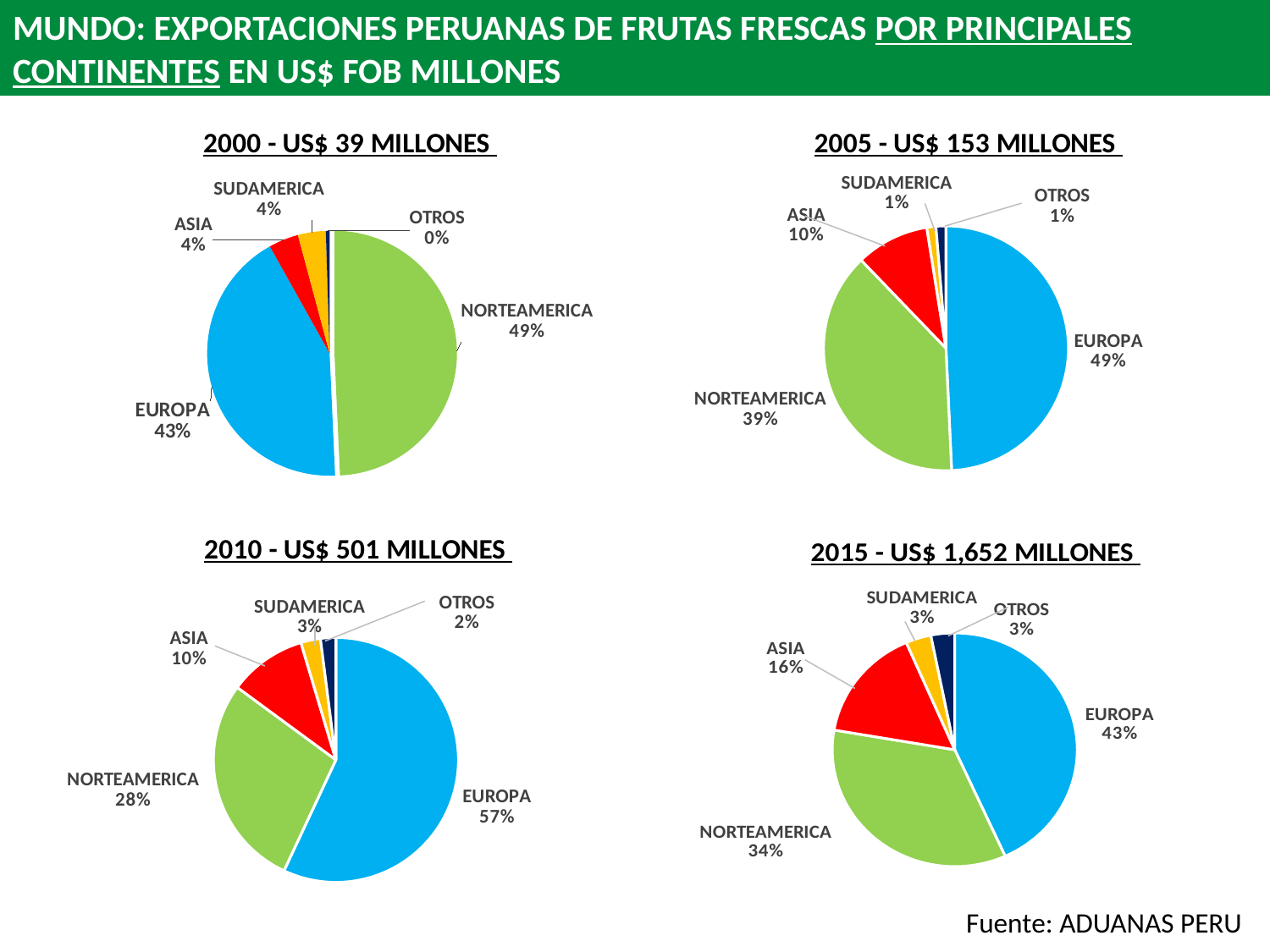
In the 2000 - US$ 39 MILLONES chart, what share does EUROPA have? 43% In the 2015 - US$ 1,652 MILLONES chart, what share does ASIA have? 16% In the 2010 - US$ 501 MILLONES chart, what is the difference between the shares of EUROPA and NORTEAMERICA? 29 percentage points In the 2015 - US$ 1,652 MILLONES chart, which is larger, the share of NORTEAMERICA or the share of ASIA? NORTEAMERICA In the 2010 - US$ 501 MILLONES chart, what share does EUROPA have? 57% How many pie charts are shown on the slide? 4 What kind of chart is used for the 2000 - US$ 39 MILLONES data? Pie chart In the 2005 - US$ 153 MILLONES chart, which continent has the largest share? EUROPA In the 2015 - US$ 1,652 MILLONES chart, which continent has the smallest share? SUDAMERICA and OTROS (both 3%) How many slices are labelled in the 2010 - US$ 501 MILLONES chart? 5